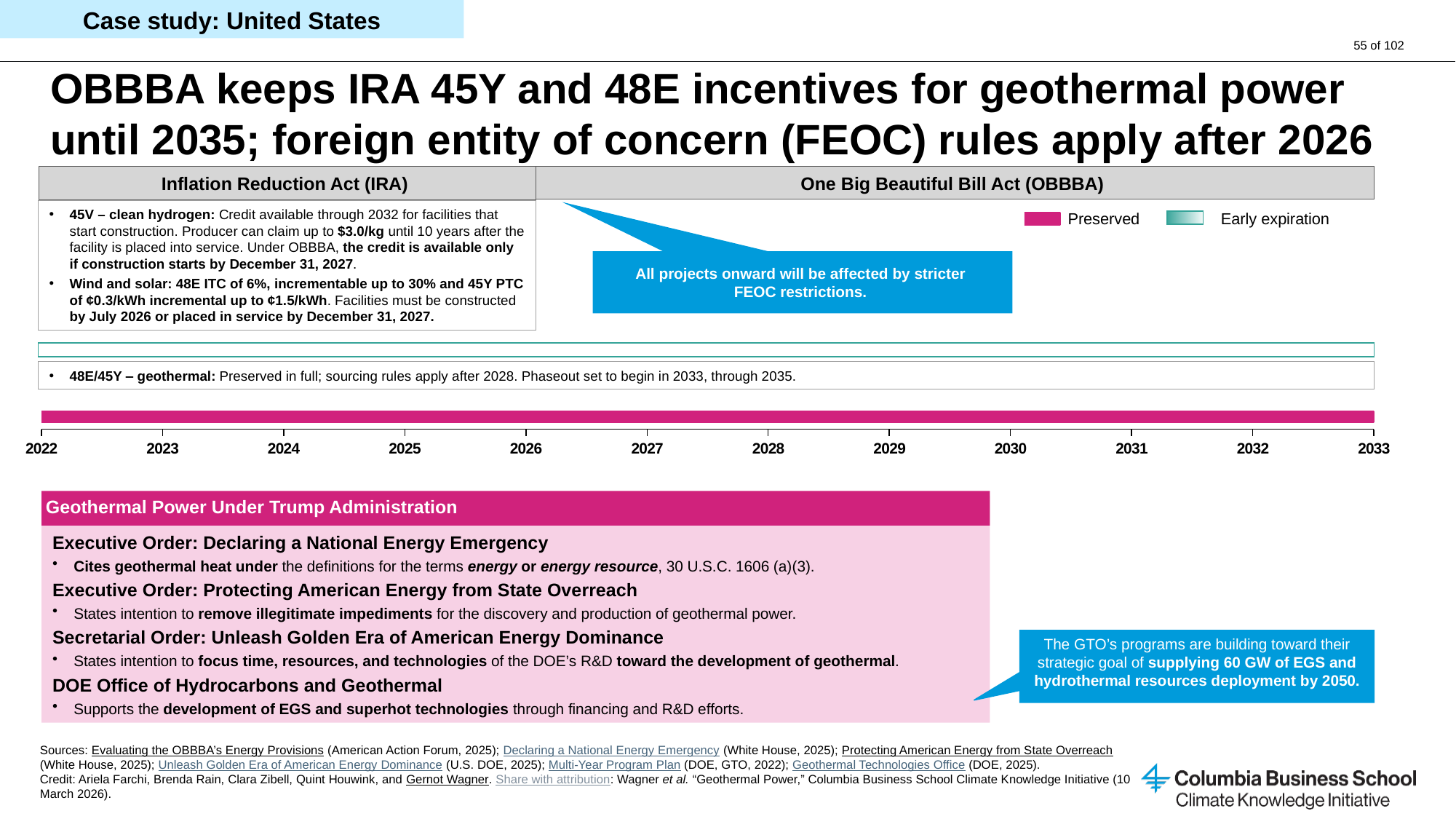
Which incentive is shown with the solid pink 'Preserved' bar on the timeline chart? 48E/45Y – geothermal What is the last year shown on the x axis of the timeline chart? 2033 Which two acts are named in the column headers above the timeline chart? Inflation Reduction Act (IRA) and One Big Beautiful Bill Act (OBBBA) What are the two legend entries on the timeline chart? Preserved and Early expiration What colour represents 'Preserved' in the timeline chart legend? Pink (magenta) How many entries does the legend of the timeline chart list? 2 What kind of chart is used to show the incentive timelines on the slide? Horizontal bar (timeline) chart How many year ticks are labelled on the x axis of the timeline chart? 12 Does the pink 'Preserved' bar on the timeline chart extend past 2030? Yes What is the first year shown on the x axis of the timeline chart? 2022